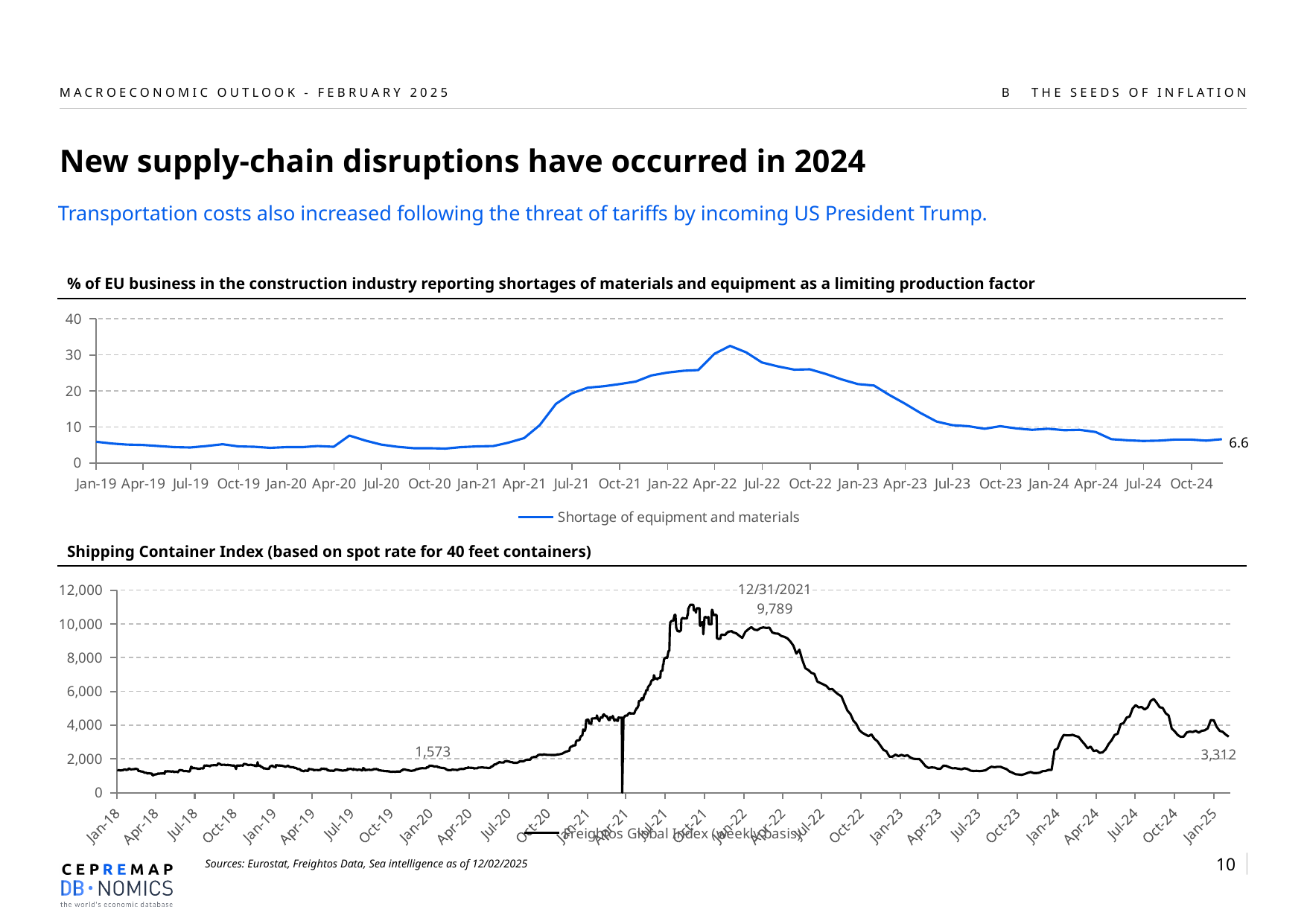
What kind of chart is the top chart, '% of EU business in the construction industry reporting shortages of materials and equipment as a limiting production factor'? Line chart In the top chart on EU construction shortages, is the peak value around mid-2022 greater or less than 30? greater In the bottom Shipping Container Index chart, is the value at Jan-18 greater or less than 2,000? less In the top chart on EU construction shortages, what is the value shown by the data label at the end of the series? 6.6 In the bottom Shipping Container Index chart, what is the difference between the 12/31/2021 value and the final labelled value? 6,477 In the top chart on EU construction shortages, do the values rise or fall between Jul-22 and Oct-24? Fall In the top chart on EU construction shortages, is the value at Jan-19 greater or less than 10? less How many series does the legend of the top chart on EU construction shortages list? 1 What kind of chart is the bottom chart, 'Shipping Container Index (based on spot rate for 40 feet containers)'? Line chart What series name does the legend of the bottom Shipping Container Index chart show? Freightos Global Index (weekly basis) In the bottom Shipping Container Index chart, what value is labelled at 12/31/2021? 9,789 In the bottom Shipping Container Index chart, what is the value shown by the data label at the end of the series? 3,312